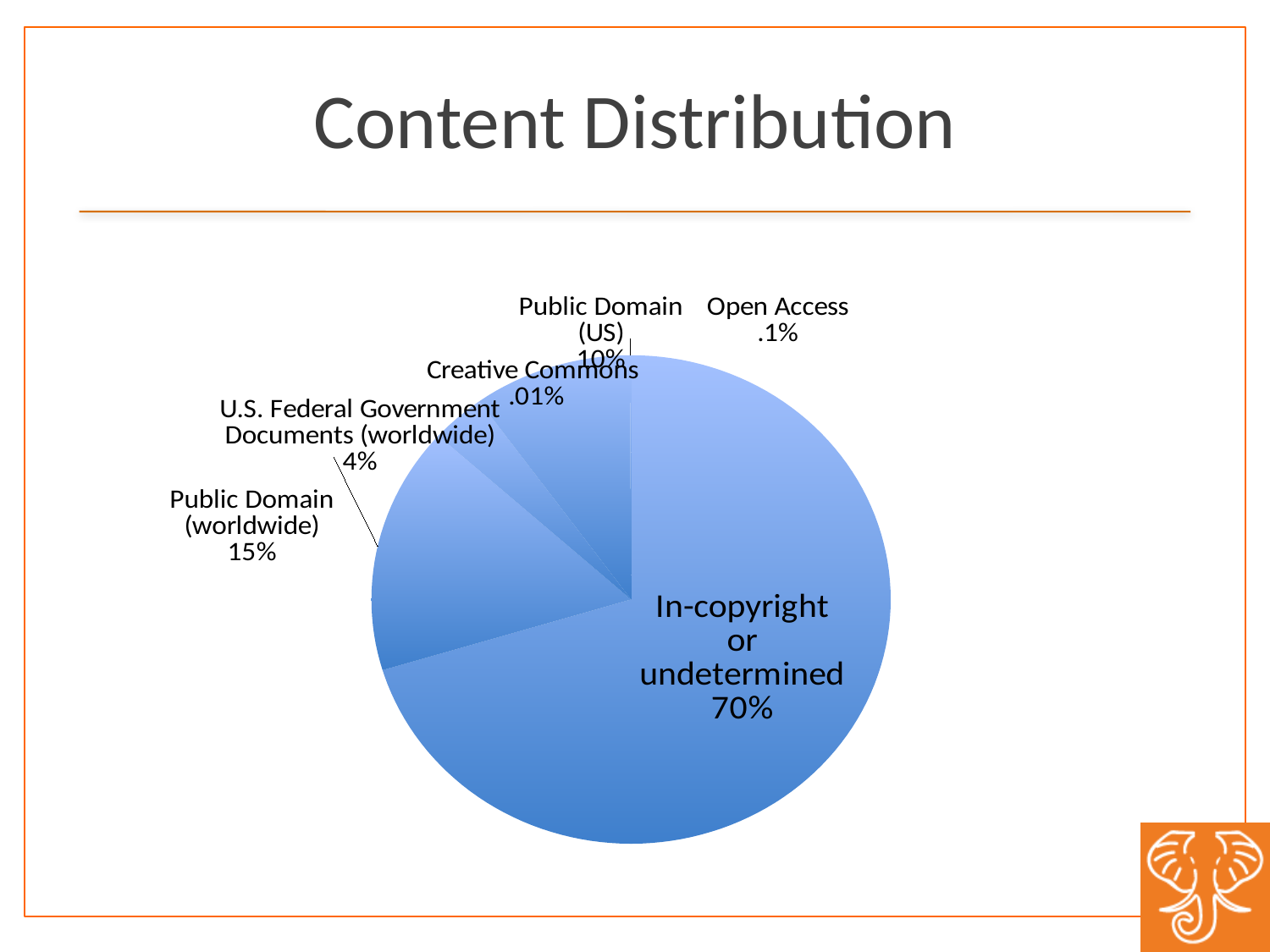
What is the title of the chart? Content Distribution What share of the pie is In-copyright or undetermined? 70% What kind of chart is shown on the slide? pie chart Which category has the smallest slice of the pie? Creative Commons What share of the pie is Public Domain (worldwide)? 15% Which category has the largest slice of the pie? In-copyright or undetermined What share of the pie is Creative Commons? .01% Which is larger, Public Domain (worldwide) or U.S. Federal Government Documents (worldwide)? Public Domain (worldwide) How many categories are shown in the pie chart? 6 What is the difference between the In-copyright or undetermined share and the Public Domain (worldwide) share? 55%